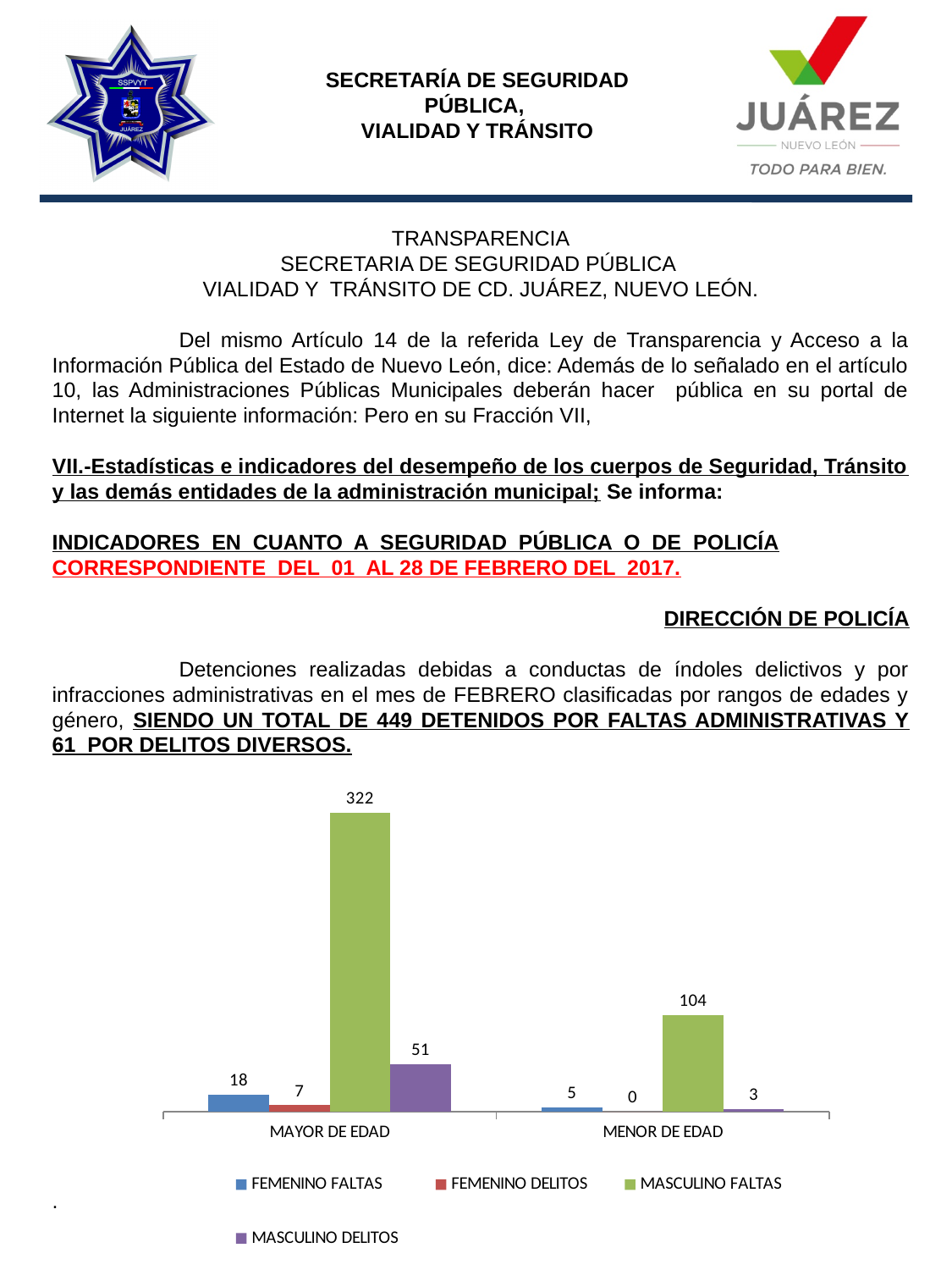
What is the value for MASCULINO FALTAS in the MAYOR DE EDAD category? 322 How many categories are shown on the x axis of the chart? 2 What is the value for MASCULINO DELITOS in the MENOR DE EDAD category? 3 What is the value for FEMENINO DELITOS in the MAYOR DE EDAD category? 7 What kind of chart is shown on the slide? Bar chart What is the total of all four series for the MENOR DE EDAD category? 112 What is the value for FEMENINO DELITOS in the MENOR DE EDAD category? 0 What is the difference between MASCULINO FALTAS for MAYOR DE EDAD and MASCULINO FALTAS for MENOR DE EDAD? 218 Which series has the lowest value in the MENOR DE EDAD category? FEMENINO DELITOS How many series does the chart legend list? 4 Which series has the highest value in the MAYOR DE EDAD category? MASCULINO FALTAS Which is larger: FEMENINO FALTAS for MAYOR DE EDAD or MASCULINO DELITOS for MAYOR DE EDAD? MASCULINO DELITOS for MAYOR DE EDAD